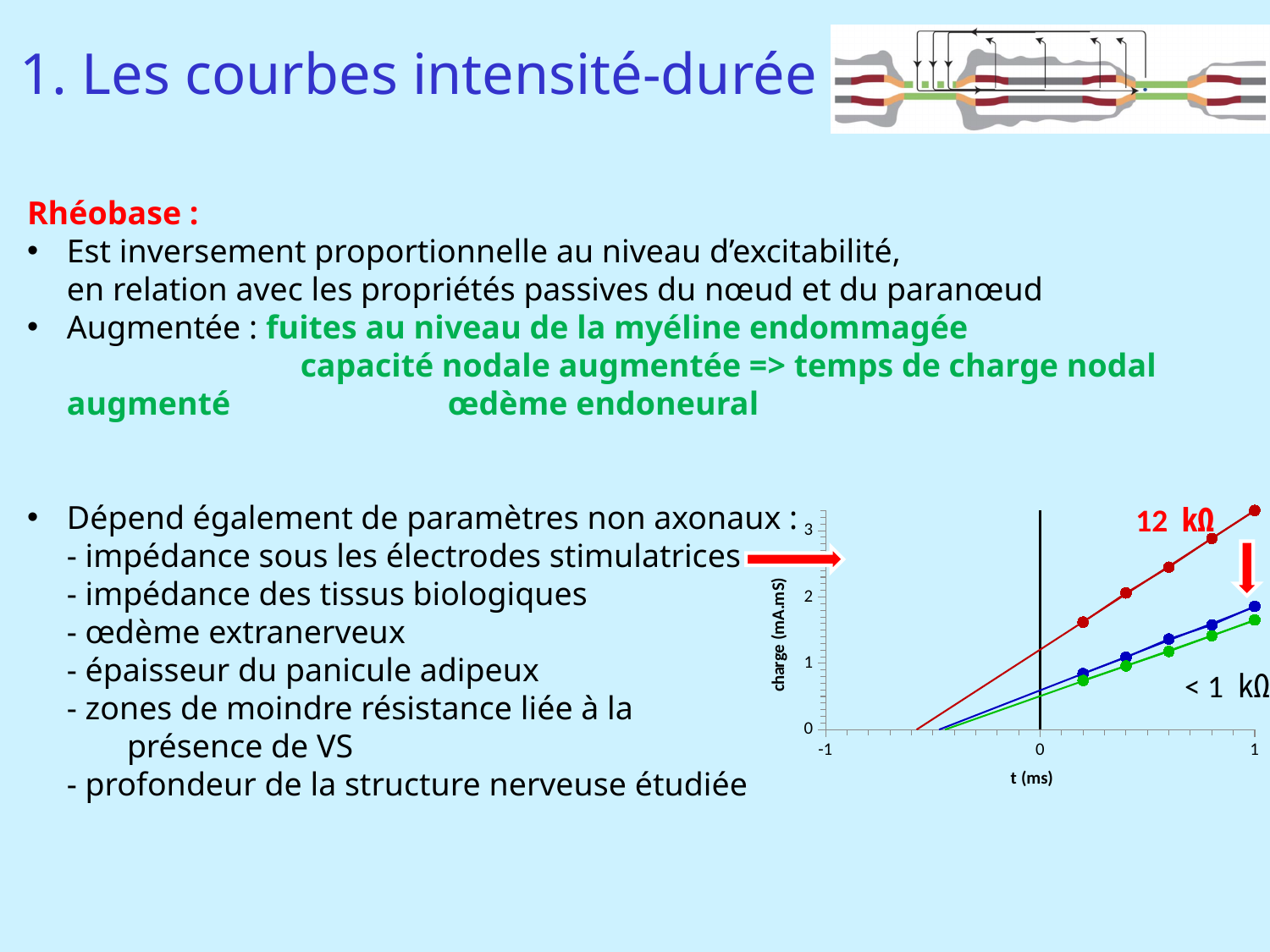
Do the values of the red line rise or fall as t increases? rise How many data points are marked on the red line? 5 At t = 1, which line has the larger value, the red line or the green line? red What is the label of the x axis of the chart? t (ms) Is the value of the red line at t = 1 greater or less than 3? greater How many lines (series) are plotted on the chart? 3 What kind of chart is shown on the slide? line chart Is the value of the blue line at t = 1 greater or less than 2? less Which coloured line has the highest values on the chart? red What is the label of the y axis of the chart? charge (mA.mS) Is the value of the red line at t = 0.2 greater or less than 1? greater Which coloured line has the lowest values on the chart? green